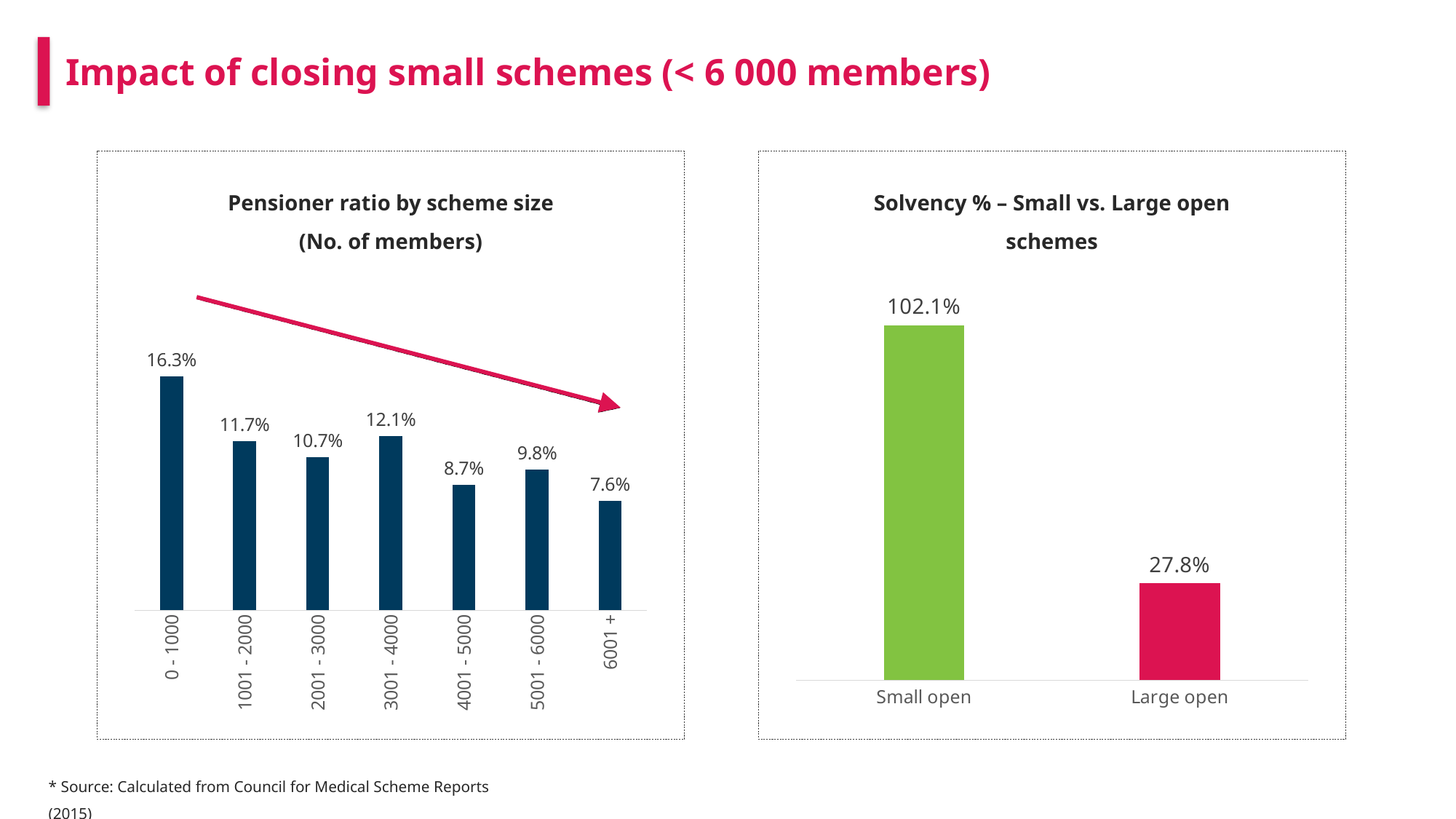
In the 'Solvency % – Small vs. Large open schemes' chart, what is the difference between the Small open and Large open values? 74.3% In the 'Pensioner ratio by scheme size' chart, what is the difference between the values for 0 - 1000 and 6001 +? 8.7% In the 'Pensioner ratio by scheme size' chart, what is the value for the 3001 - 4000 category? 12.1% In the 'Pensioner ratio by scheme size' chart, what is the pensioner ratio for schemes with 0 - 1000 members? 16.3% What is the overall trend of the pensioner ratio as scheme size increases in the 'Pensioner ratio by scheme size' chart? Falling In the 'Pensioner ratio by scheme size' chart, which is larger: the value for 4001 - 5000 or 5001 - 6000? 5001 - 6000 In the 'Solvency % – Small vs. Large open schemes' chart, what is the solvency % for Large open schemes? 27.8% In the 'Pensioner ratio by scheme size' chart, which scheme size has the lowest pensioner ratio? 6001 + How many scheme size categories are shown in the 'Pensioner ratio by scheme size' chart? 7 What type of chart is the 'Solvency % – Small vs. Large open schemes' chart? Bar chart In the 'Solvency % – Small vs. Large open schemes' chart, what is the solvency % for Small open schemes? 102.1% In the 'Pensioner ratio by scheme size' chart, which scheme size has the highest pensioner ratio? 0 - 1000